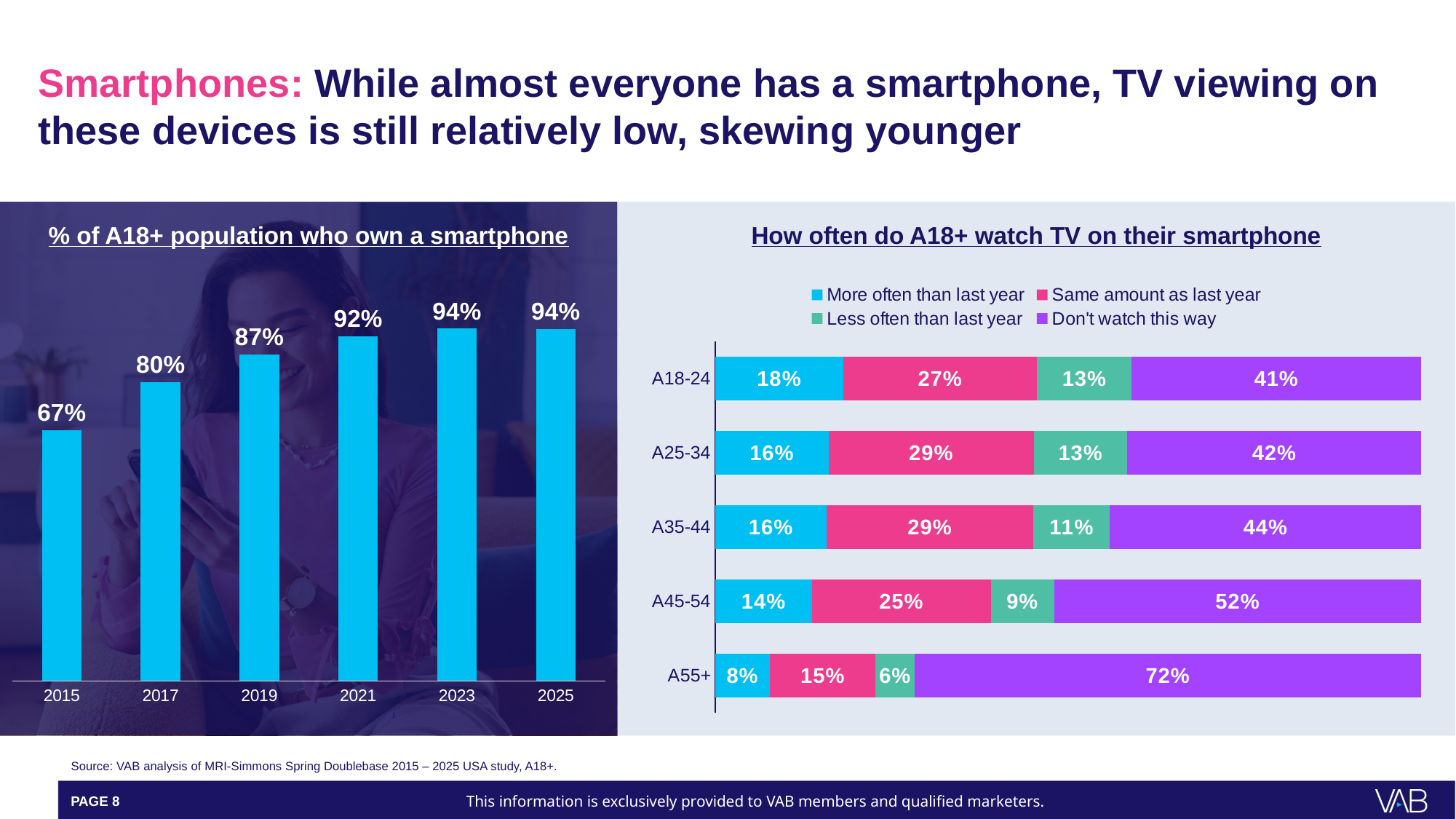
In the '% of A18+ population who own a smartphone' chart, what is the value for 2015? 67% In the '% of A18+ population who own a smartphone' chart, what is the value for 2019? 87% In the '% of A18+ population who own a smartphone' chart, which year has the lowest value? 2015 In the 'How often do A18+ watch TV on their smartphone' chart, what is the 'Same amount as last year' value for A45-54? 25% In the 'How often do A18+ watch TV on their smartphone' chart, which age group has the highest 'More often than last year' value? A18-24 In the '% of A18+ population who own a smartphone' chart, how many years are shown on the x axis? 6 In the '% of A18+ population who own a smartphone' chart, what is the difference between the 2025 value and the 2015 value? 27 percentage points In the 'How often do A18+ watch TV on their smartphone' chart, how many series does the legend list? 4 In the '% of A18+ population who own a smartphone' chart, do the values rise or fall from 2015 to 2025? rise What kind of chart is the '% of A18+ population who own a smartphone' chart? bar chart In the 'How often do A18+ watch TV on their smartphone' chart, is the 'Don't watch this way' value larger for A35-44 or A45-54? A45-54 In the 'How often do A18+ watch TV on their smartphone' chart, what is the 'Don't watch this way' value for A55+? 72%